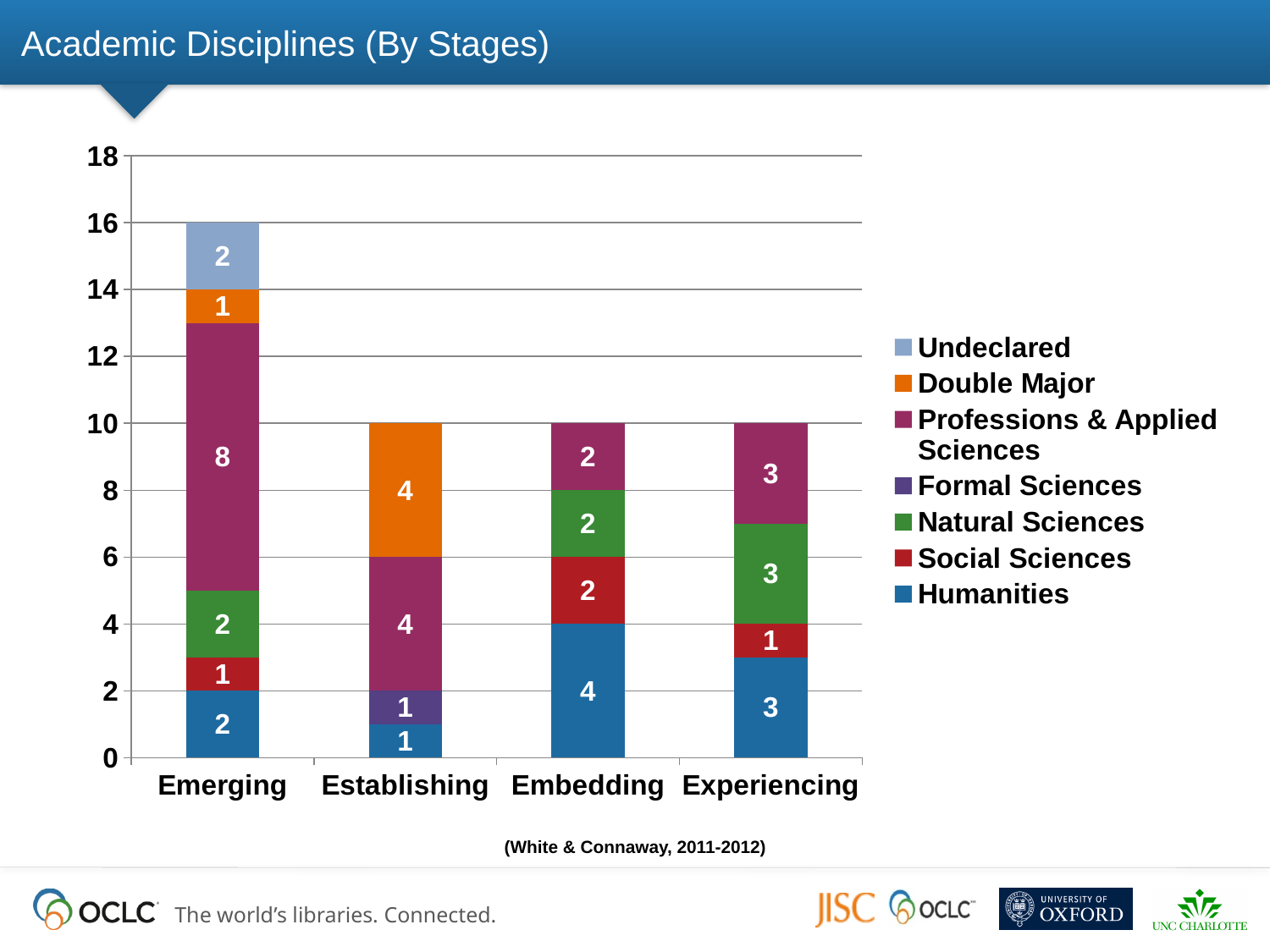
Which is larger: the Natural Sciences value for Experiencing or for Embedding? Experiencing Which stage is the only one with a Formal Sciences segment? Establishing What is the total of the stacked bar for the Experiencing stage? 10 What is the difference between the Humanities values for Embedding and Establishing? 3 Which stage has the highest total bar? Emerging How many series does the legend list? 7 What is the Double Major value for the Establishing stage? 4 How many stages (categories) are shown on the x axis? 4 What type of chart is shown on the slide? Stacked bar chart What is the Professions & Applied Sciences value for the Emerging stage? 8 What is the Humanities value for the Embedding stage? 4 What is the total of the stacked bar for the Emerging stage? 16